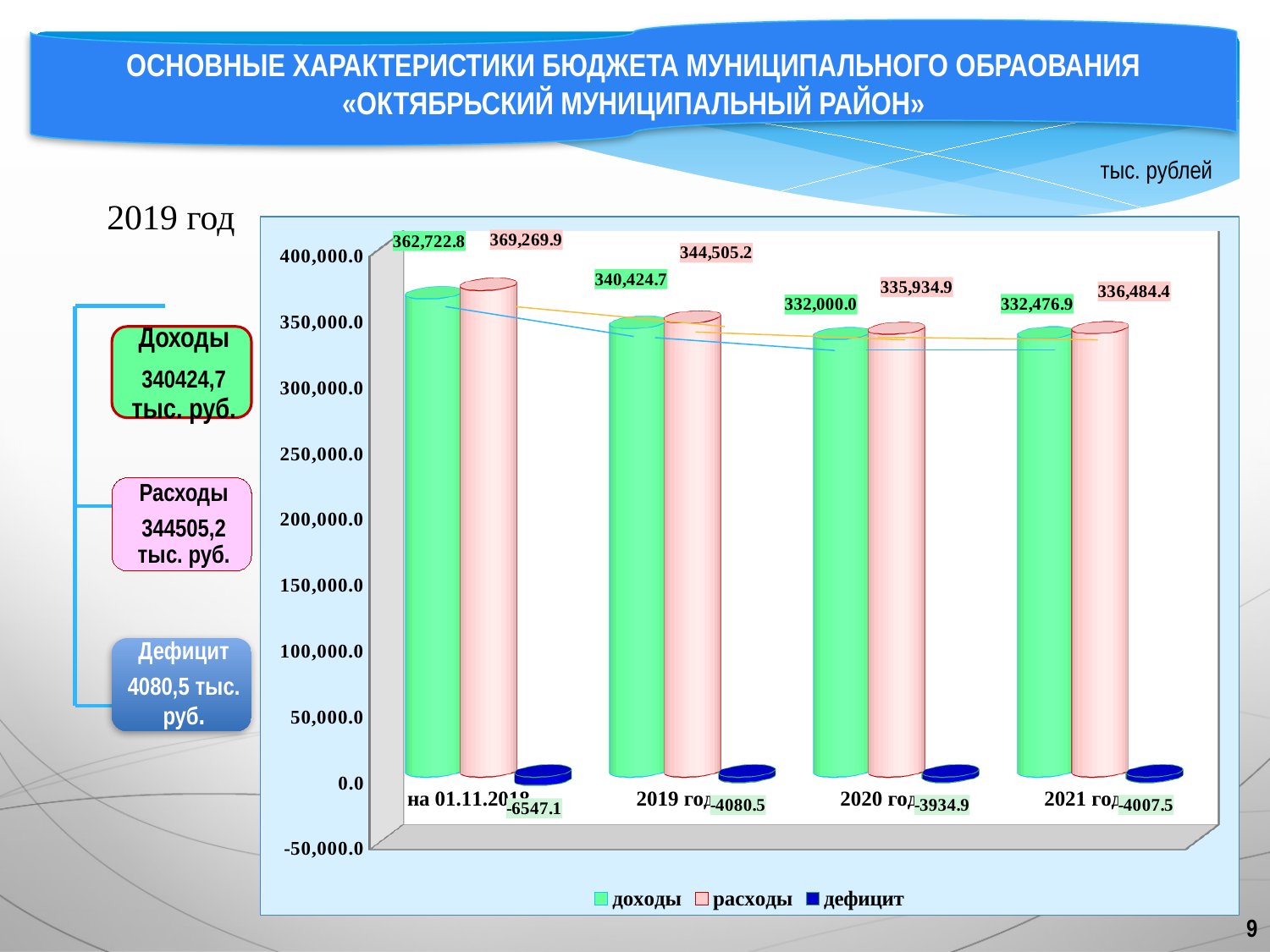
What kind of chart is shown on the slide? bar chart By how much do расходы exceed доходы in 2019 год? 4,080.5 How many categories are shown on the x axis of the chart? 4 Which is larger: доходы for 2020 год or доходы for 2021 год? 2021 год What is the value of расходы for 2020 год? 335,934.9 Among 2019 год, 2020 год and 2021 год, which has the highest расходы? 2019 год What is the value of дефицит for 2021 год? -4007.5 What is the value of доходы for 2019 год? 340,424.7 Is the value of доходы for 2020 год greater or less than 300,000.0? greater What is the value of расходы for the leftmost category (на 01.11.201...)? 369,269.9 Which category has the lowest доходы? 2020 год How many series does the chart legend list? 3